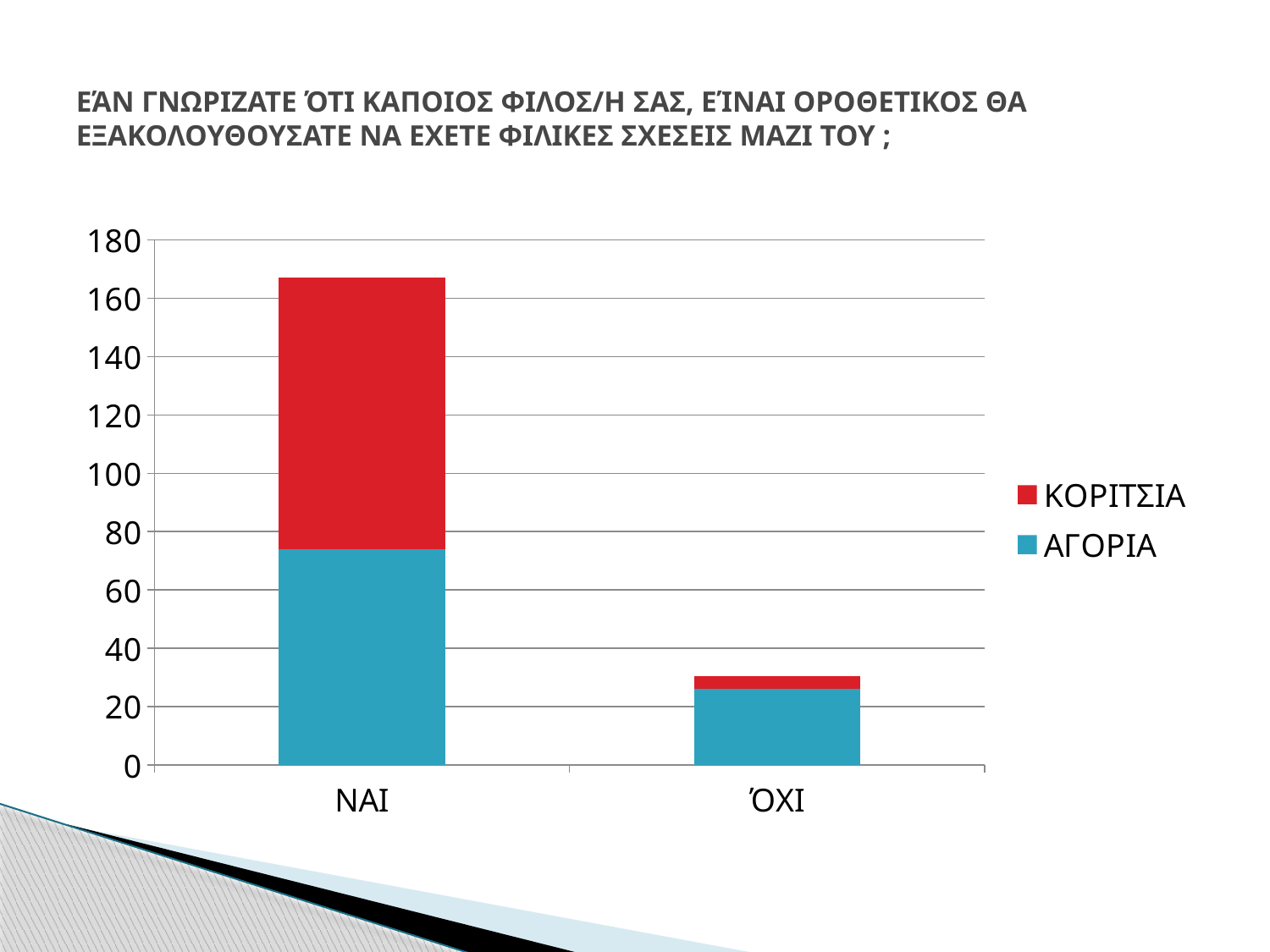
Within the ΌΧΙ bar, which series has the larger value, ΚΟΡΙΤΣΙΑ or ΑΓΟΡΙΑ? ΑΓΟΡΙΑ Within the ΝΑΙ bar, which series has the larger value, ΚΟΡΙΤΣΙΑ or ΑΓΟΡΙΑ? ΚΟΡΙΤΣΙΑ Is the ΑΓΟΡΙΑ value for ΝΑΙ greater or less than 60? greater How many categories are shown on the x axis of the chart? 2 Is the total of the stacked bar for ΝΑΙ greater or less than 160? greater Which colour represents the ΚΟΡΙΤΣΙΑ series in the legend? Red Which category has the tallest stacked bar, ΝΑΙ or ΌΧΙ? ΝΑΙ Which category has the shortest stacked bar? ΌΧΙ What kind of chart is shown on the slide? Stacked bar chart Is the total of the stacked bar for ΌΧΙ greater or less than 40? less How many series does the chart's legend list? 2